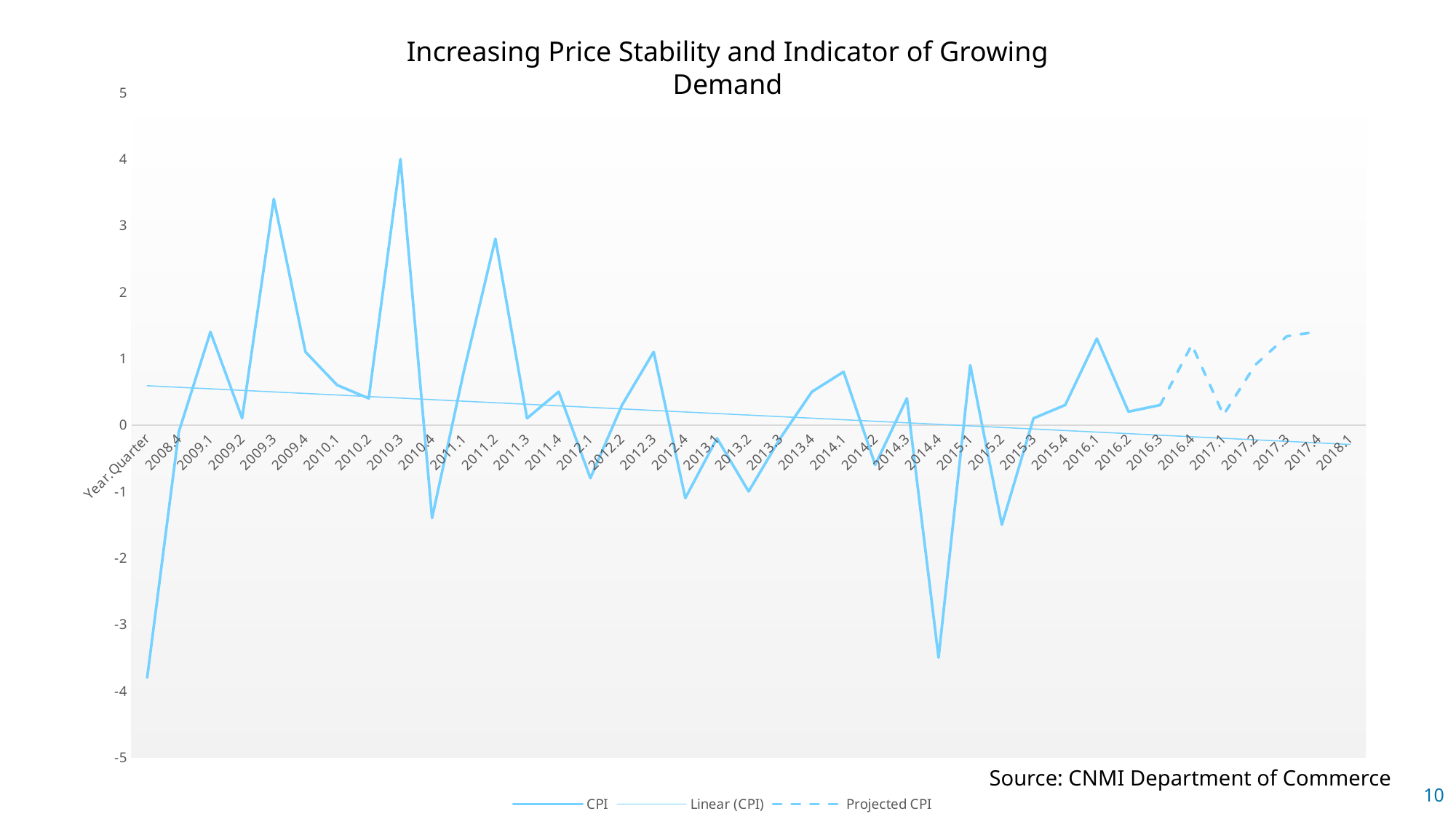
How many series does the legend list? 3 Does the Linear (CPI) trend line rise or fall from left to right? Fall Is the CPI value for 2009.3 greater or less than 3? greater Which has the larger CPI value, 2010.3 or 2009.3? 2010.3 What kind of chart is shown on the slide? Line chart Which series is drawn with a dashed line? Projected CPI Which quarter has the highest CPI value? 2010.3 Which has the larger CPI value, 2014.4 or 2015.2? 2015.2 Is the CPI value for 2010.3 greater or less than 3? greater Is the CPI value for 2015.2 greater or less than -1? less